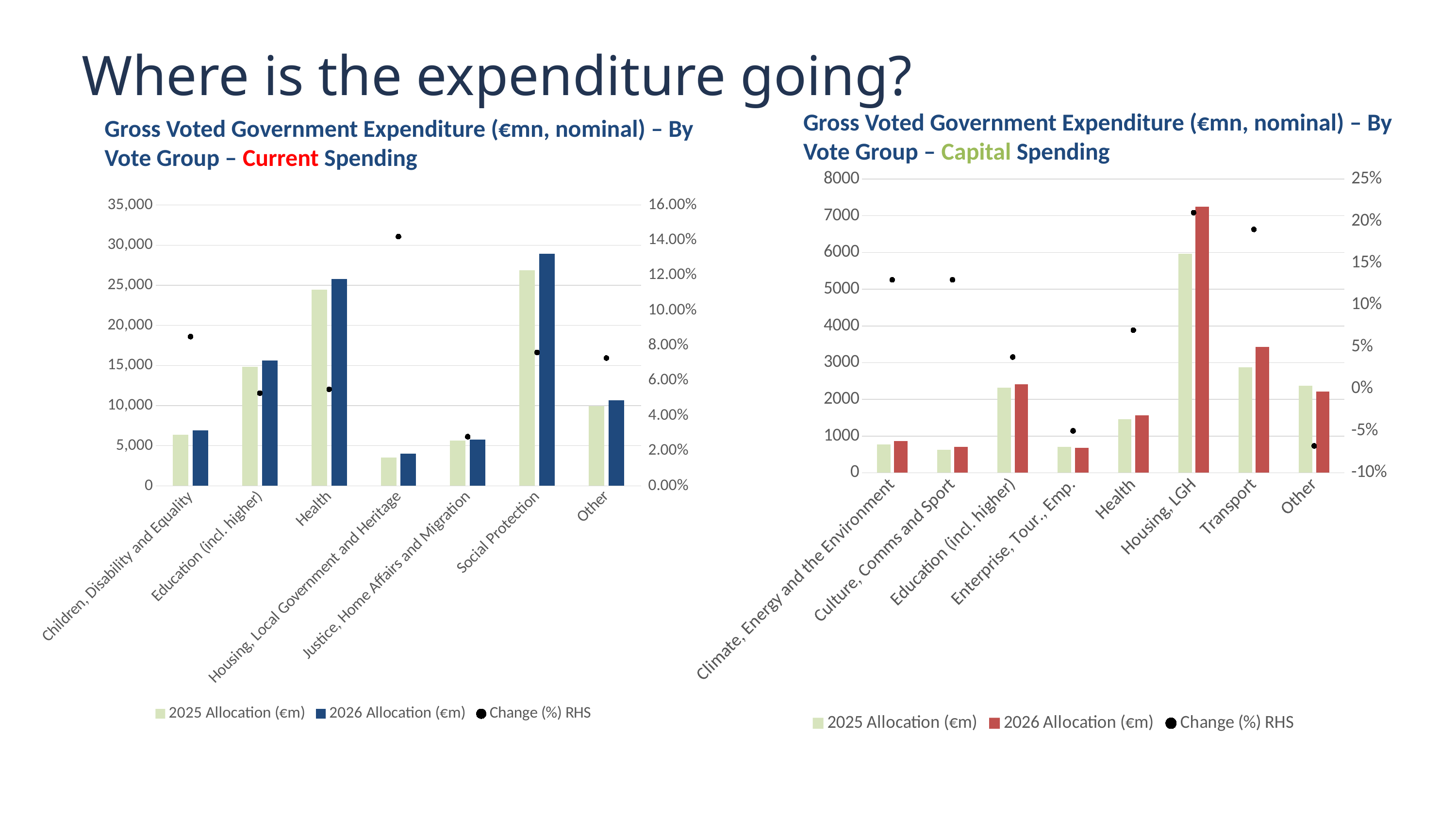
On the Current Spending chart, which vote group has the highest 2026 Allocation? Social Protection On the Current Spending chart, which vote group has the lowest 2025 Allocation? Housing, Local Government and Heritage On the Capital Spending chart, how many vote group categories are shown on the x axis? 8 On the Current Spending chart, which vote group has the highest Change (%)? Housing, Local Government and Heritage On the Current Spending chart, is the 2026 Allocation for Social Protection greater or less than 25,000? greater On the Capital Spending chart, is the 2026 Allocation for Transport greater or less than 3000? greater On the Current Spending chart, how many series does the legend list? 3 On the Current Spending chart, how many vote group categories are shown on the x axis? 7 On the Capital Spending chart, which vote group has the lowest Change (%)? Other What kind of chart is the Capital Spending chart? bar chart On the Capital Spending chart, which is larger: the 2026 Allocation for Transport or for Education (incl. higher)? Transport On the Capital Spending chart, which vote group has the highest 2026 Allocation? Housing, LGH